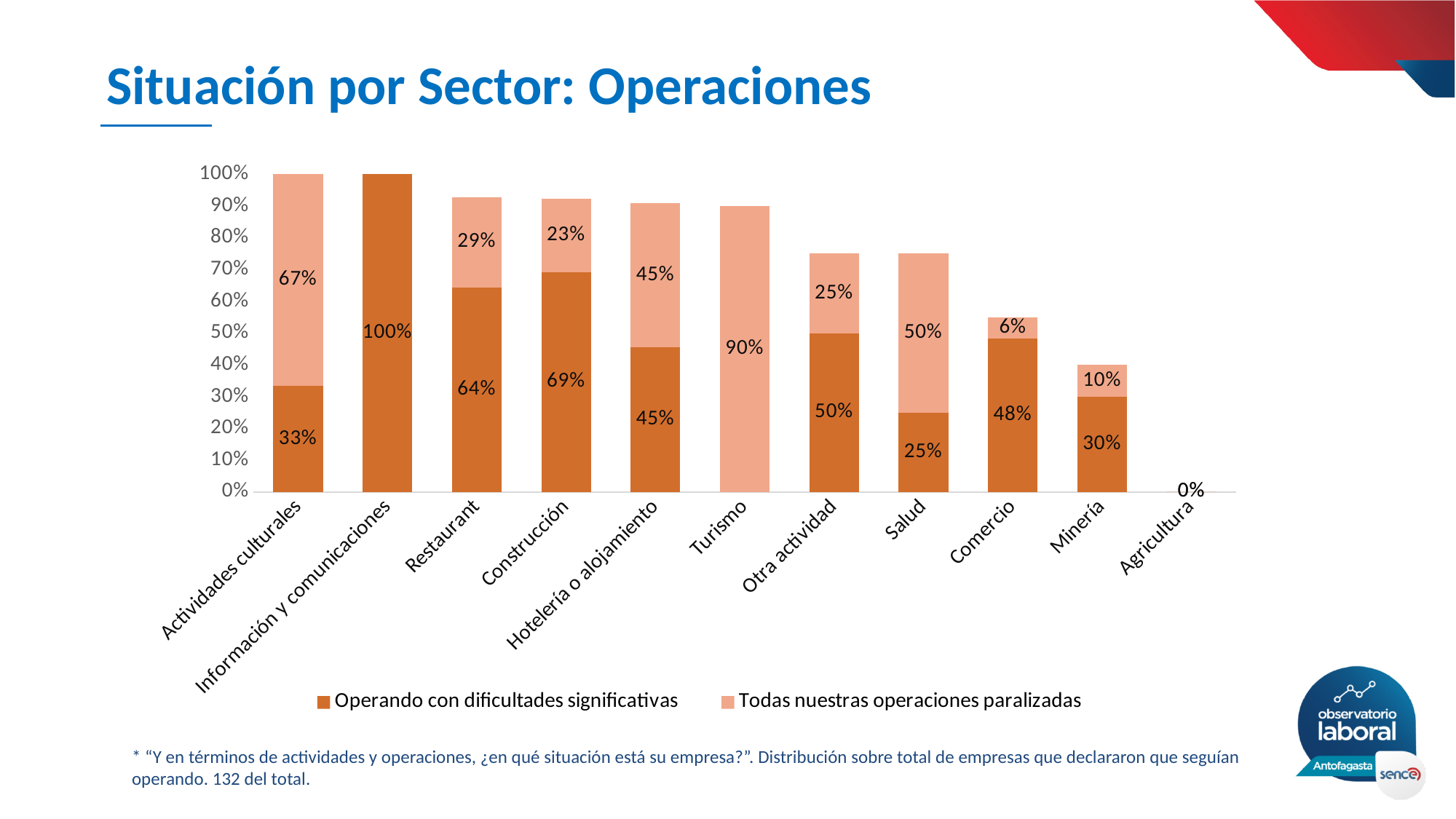
What is the value of 'Todas nuestras operaciones paralizadas' for Salud? 50% What is the title of the slide? Situación por Sector: Operaciones What is the total of the stacked bar for Comercio? 54% Which sector has the highest value for 'Operando con dificultades significativas'? Información y comunicaciones How many sectors are shown on the x axis? 11 What percentage of Restaurant businesses are 'Operando con dificultades significativas'? 64% How many series does the legend list? 2 What is the difference between the 'Operando con dificultades significativas' values for Construcción and Minería? 39% What is the value of 'Todas nuestras operaciones paralizadas' for Turismo? 90% Which is larger: the 'Todas nuestras operaciones paralizadas' value for Actividades culturales or for Hotelería o alojamiento? Actividades culturales What kind of chart is shown on the slide? Stacked bar chart